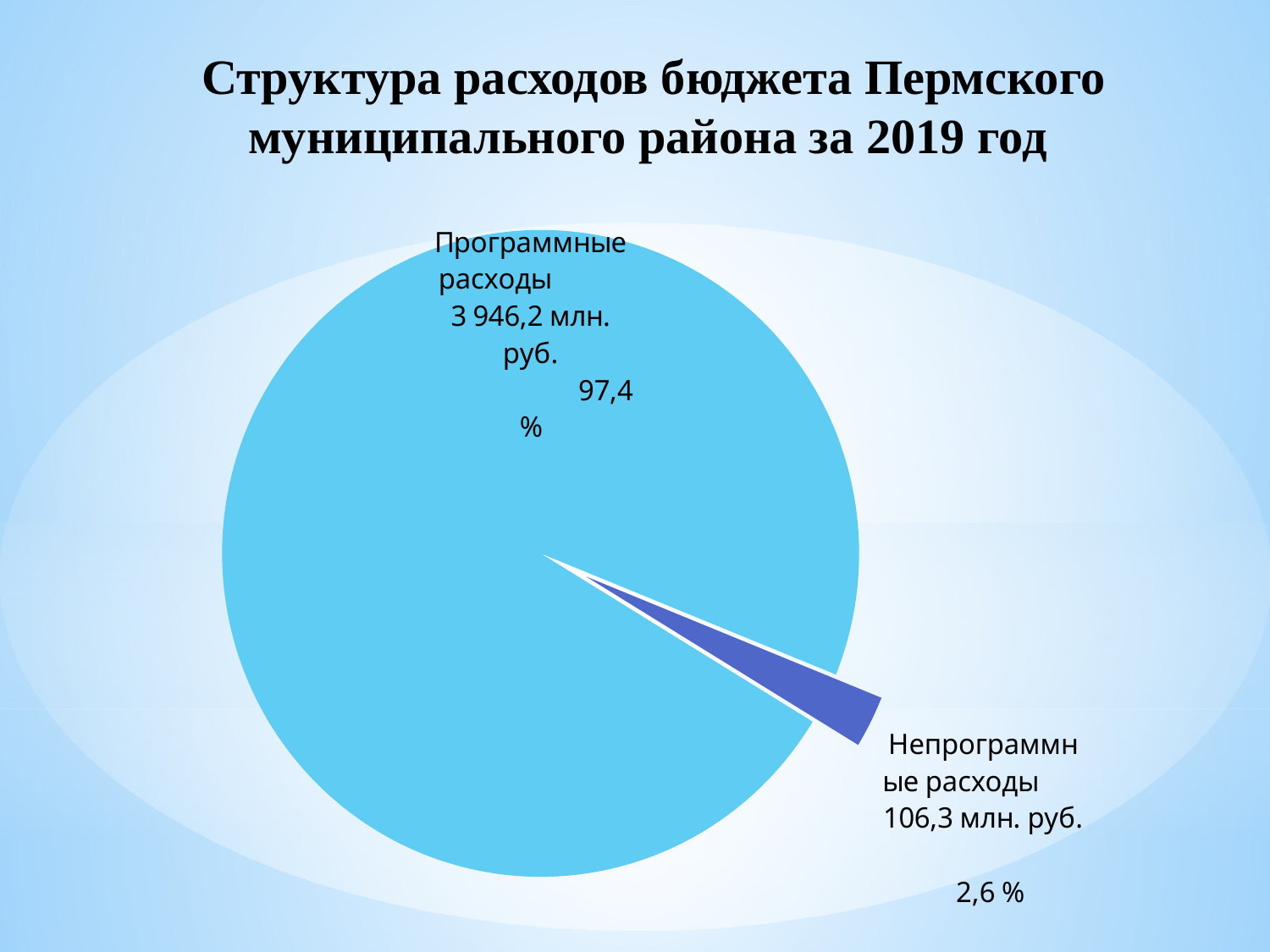
What share of the pie does Программные расходы take? 97,4 % Which is larger, Программные расходы or Непрограммные расходы? Программные расходы Which slice is the smallest? Непрограммные расходы What kind of chart is shown on the slide? pie chart What share of the pie does Непрограммные расходы take? 2,6 % What is the value for Программные расходы? 3 946,2 млн. руб. What colour is the Непрограммные расходы slice? dark blue What is the title of the chart? Структура расходов бюджета Пермского муниципального района за 2019 год What is the value for Непрограммные расходы? 106,3 млн. руб. How many slices does the pie chart have? 2 Which slice is the largest? Программные расходы What is the difference in млн. руб. between Программные расходы and Непрограммные расходы? 3 839,9 млн. руб.